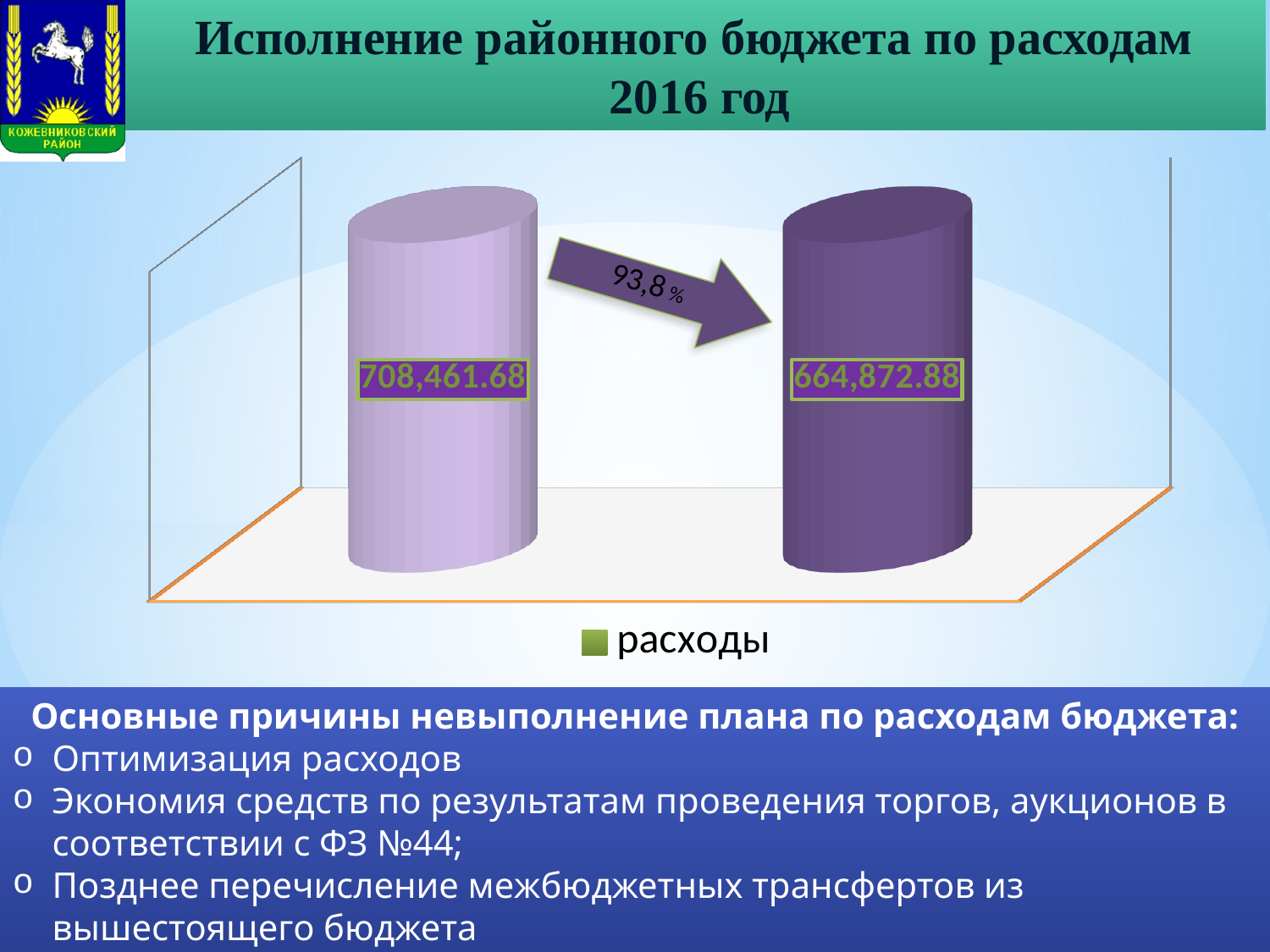
What is the difference between the left bar value (708,461.68) and the right bar value (664,872.88)? 43,588.80 What percentage is written on the arrow between the two bars? 93,8 % What is the value shown on the right bar of the chart? 664,872.88 How many bars are plotted in the chart? 2 What series name is shown in the chart legend? расходы What kind of chart is shown on the slide? bar chart How many series does the chart legend list? 1 Which bar has the higher value, the left or the right? left Which bar has the lower value, the left or the right? right Do the values rise or fall from the left bar to the right bar? fall What is the value shown on the left bar of the chart? 708,461.68 Is the value of the right bar larger or smaller than the value of the left bar? smaller